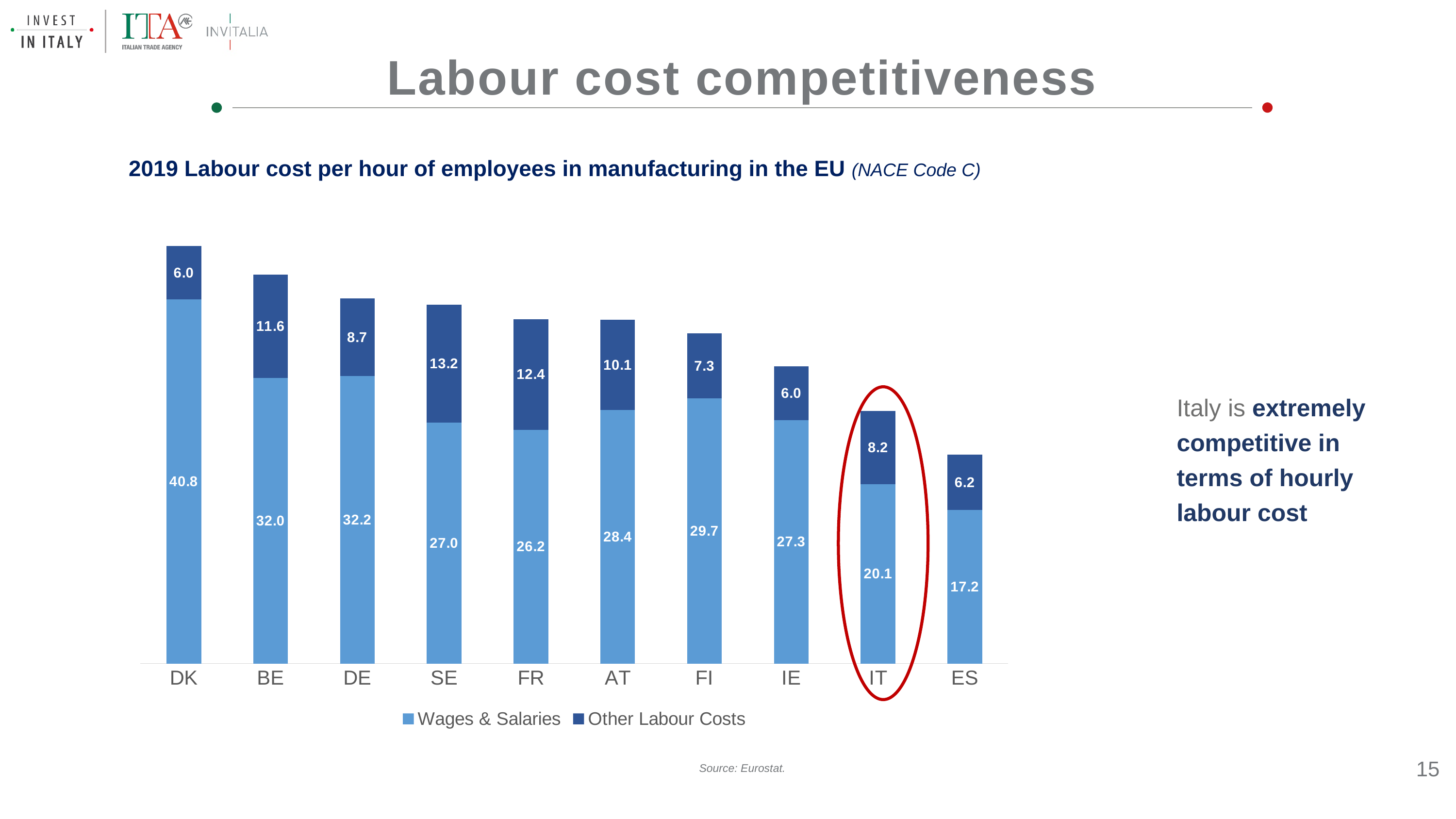
Which country has the lowest Wages & Salaries value? ES What is the Wages & Salaries value for DK? 40.8 What is the Wages & Salaries value for IT? 20.1 What kind of chart is shown on the slide? Stacked bar chart Which country has the highest Other Labour Costs value? SE What is the difference between the Wages & Salaries values for DK and IT? 20.7 How many countries are shown on the x axis? 10 Which country's bar is circled in red on the chart? IT Which is larger, the Other Labour Costs value for BE or for DE? BE How many series does the legend list? 2 What is the Other Labour Costs value for SE? 13.2 What is the total labour cost per hour for IT (Wages & Salaries plus Other Labour Costs)? 28.3